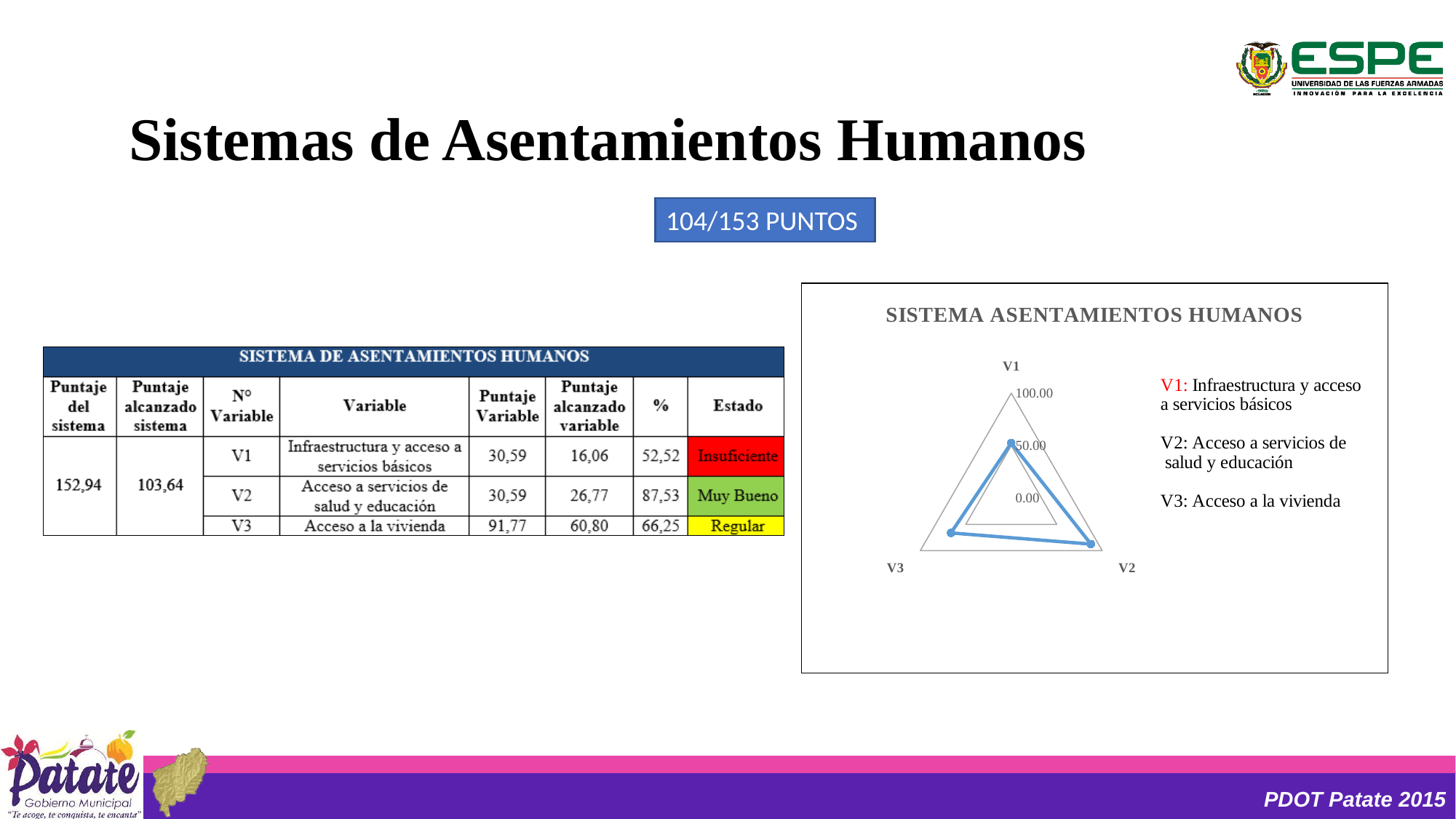
Is the value for V1 on the radar chart greater or less than 100.00? less Which variable has the highest value on the radar chart? V2 Which variable has the lowest value on the radar chart? V1 What is the title of the chart on the slide? SISTEMA ASENTAMIENTOS HUMANOS What kind of chart is shown on the slide? radar chart How many variables (axes) does the radar chart plot? 3 What is the highest tick value shown on the radar chart's axis? 100.00 Is the value for V2 on the radar chart greater or less than 50.00? greater On the radar chart, which is larger, the value for V3 or the value for V1? V3 Is the value for V3 on the radar chart greater or less than 50.00? greater On the radar chart, which is larger, the value for V2 or the value for V3? V2